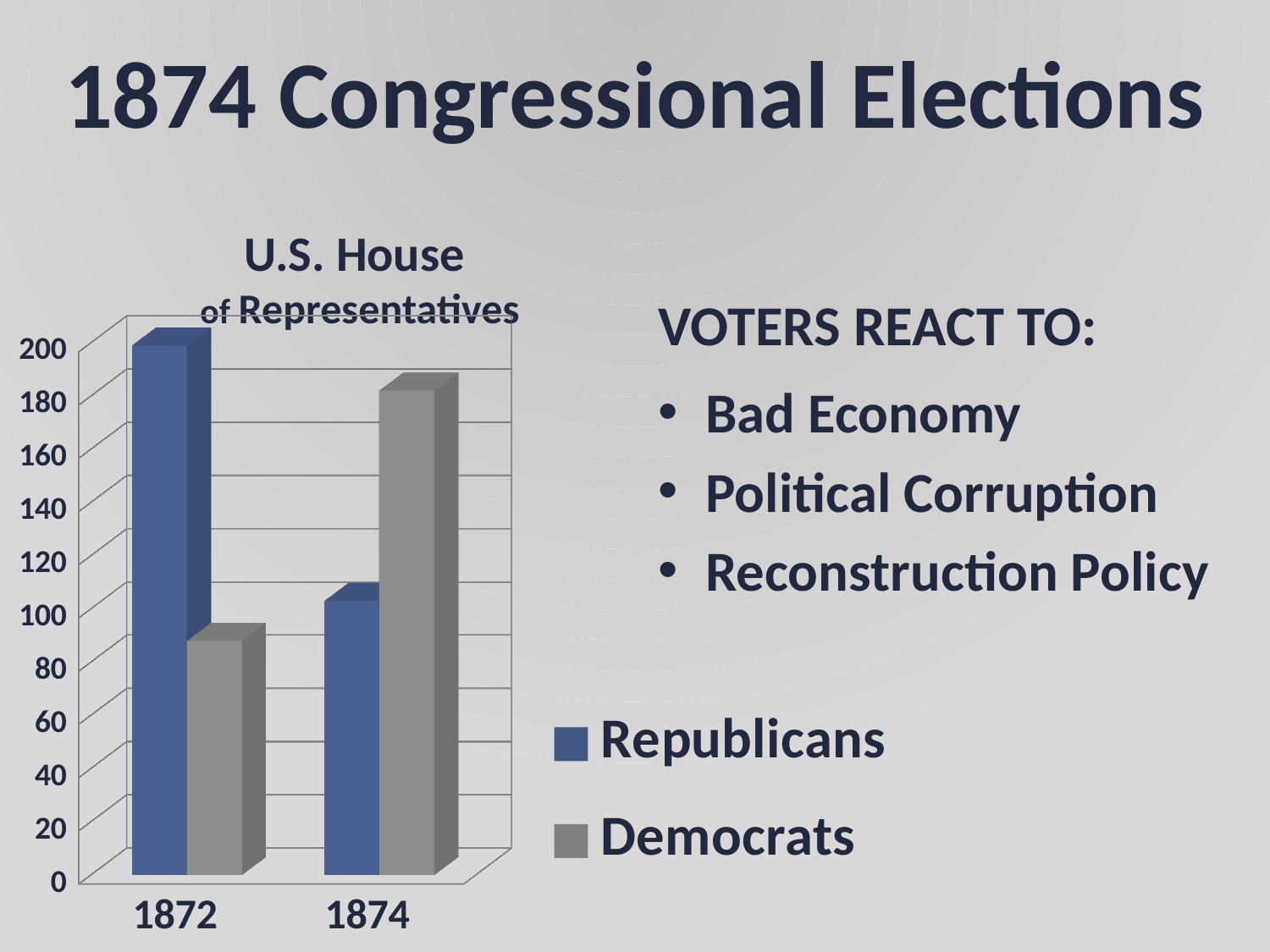
What kind of chart is shown on the slide? bar chart Is the value for Democrats in 1874 greater or less than 160? greater Which party had more seats in 1874, Republicans or Democrats? Democrats Do the Republicans' values rise or fall from 1872 to 1874? fall Is the value for Republicans in 1872 greater or less than 180? greater Is the value for Republicans in 1874 greater or less than 120? less Which bar is the tallest in the chart? Republicans in 1872 What is the title of the chart? U.S. House of Representatives Which series is shown in blue in the chart? Republicans How many years are shown on the x axis of the chart? 2 How many series does the chart legend list? 2